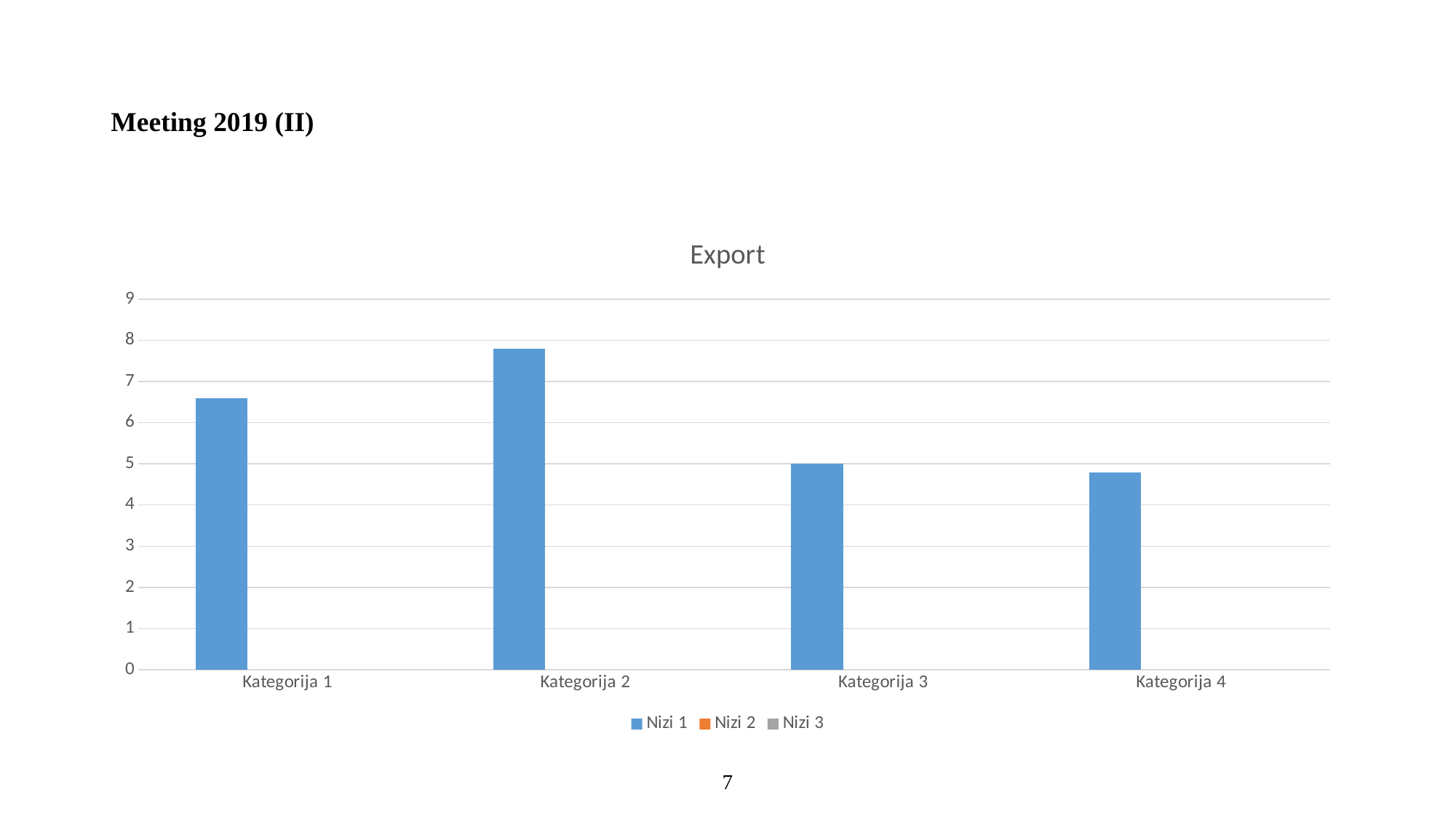
Which is larger, the value for Kategorija 1 or the value for Kategorija 2? Kategorija 2 What kind of chart is shown on the slide? bar chart How many categories are shown on the x axis of the chart? 4 Is the value for Kategorija 1 greater or less than 6? greater Is the value for Kategorija 2 greater or less than 7? greater What is the title of the chart? Export What is the value for Kategorija 3 in the chart? 5 Is the value for Kategorija 4 greater or less than 5? less Which category has the highest bar in the chart? Kategorija 2 How many series does the legend of the chart list? 3 Do the values rise or fall from Kategorija 2 to Kategorija 3? fall Which category has the lowest bar in the chart? Kategorija 4